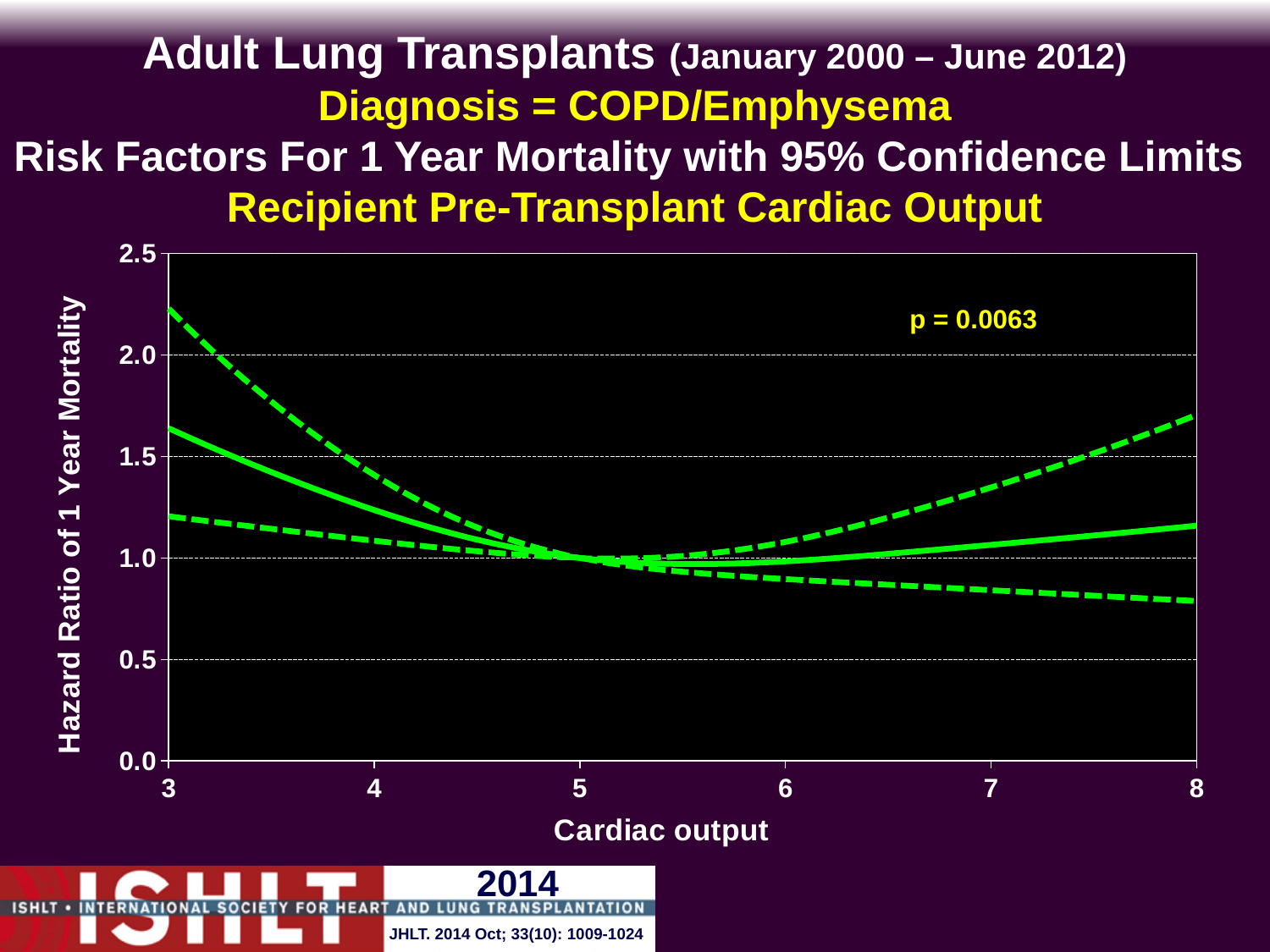
What kind of chart is shown on the slide? line chart Is the value of the upper dashed line at a cardiac output of 8 greater or less than 1.5? greater Is the value of the solid line at a cardiac output of 3 greater or less than 1.5? greater What is the label of the x axis? Cardiac output Is the solid line's value larger at a cardiac output of 3 or at a cardiac output of 8? 3 Does the solid line rise or fall as cardiac output increases from 3 to 5? fall Is the value of the lower dashed line at a cardiac output of 8 greater or less than 1.0? less Does the upper dashed line rise or fall as cardiac output increases from 6 to 8? rise How many lines are plotted on the chart? 3 What p-value is printed on the chart? p = 0.0063